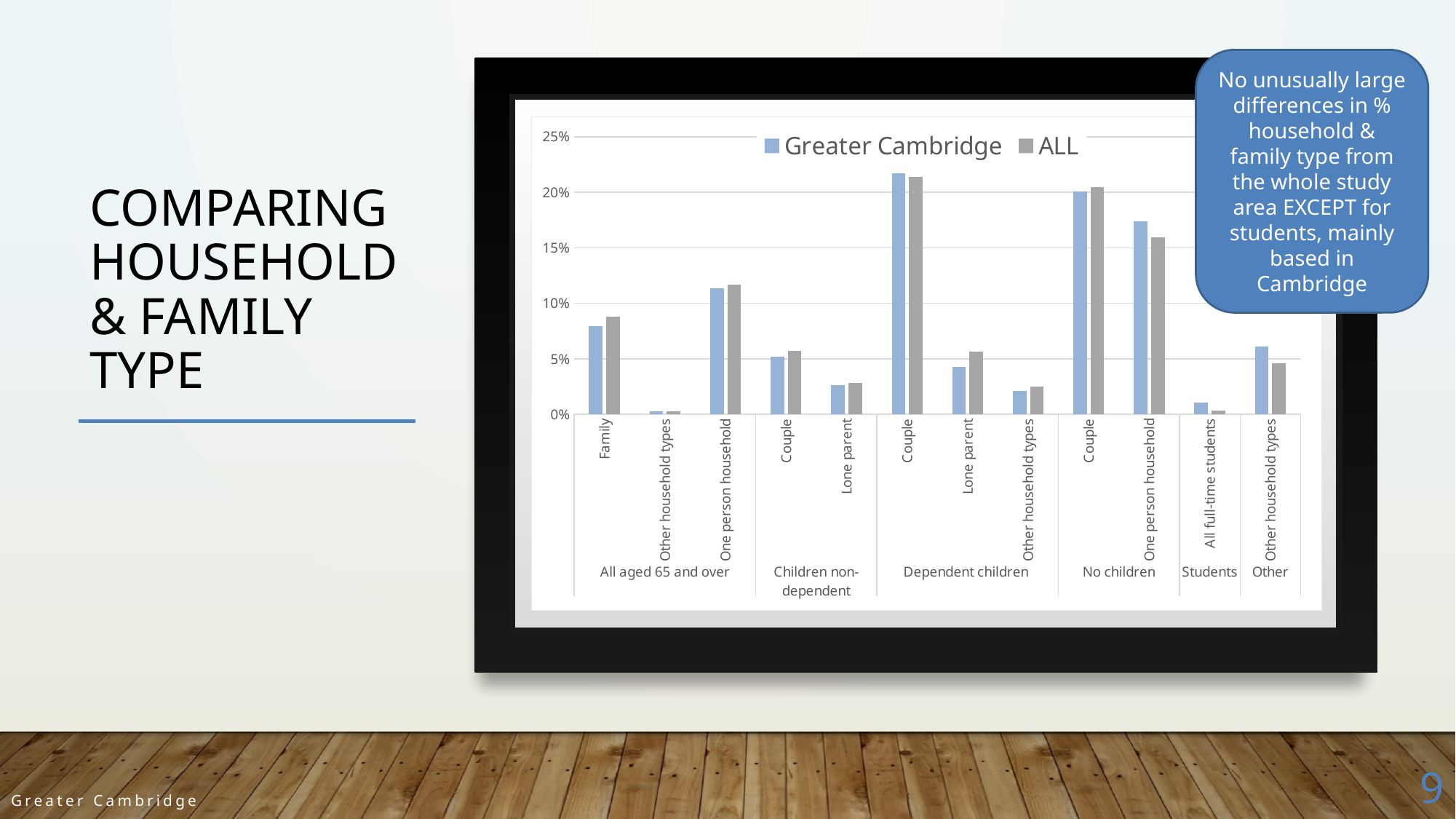
What kind of chart is shown on the slide? Bar chart Which colour represents the Greater Cambridge series in the chart? Blue How many series does the chart legend list? 2 Which two series are listed in the chart legend? Greater Cambridge and ALL How many household type categories are plotted along the x axis of the chart? 12 Is the Greater Cambridge value for All full-time students greater or less than 5%? less Is the Greater Cambridge value for Family under All aged 65 and over greater or less than 5%? greater For All full-time students, which series has the larger value, Greater Cambridge or ALL? Greater Cambridge For Family under All aged 65 and over, which series has the larger value, Greater Cambridge or ALL? ALL Which category has the lowest Greater Cambridge value in the chart? Other household types (All aged 65 and over) Is the ALL value for One person household under No children greater or less than 15%? greater Which category has the highest Greater Cambridge value in the chart? Couple (Dependent children)